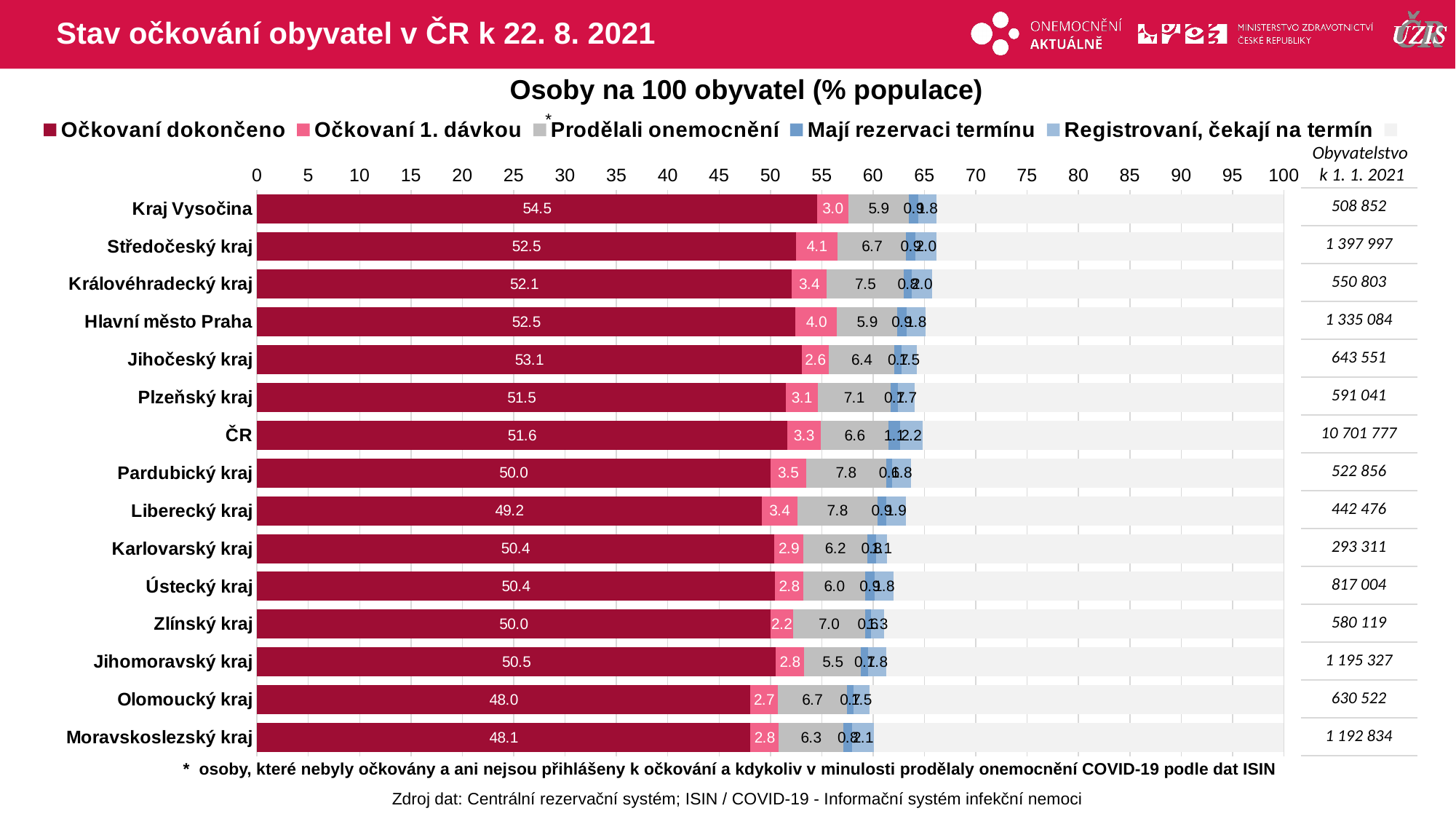
What type of chart is shown on the slide? Stacked bar chart How many regions (categories) are plotted in the chart? 15 What is the 'Očkovaní 1. dávkou' value for Hlavní město Praha? 4.0 Which region has the lowest 'Očkovaní 1. dávkou' value? Zlínský kraj What is the title of the chart? Osoby na 100 obyvatel (% populace) Is the 'Očkovaní dokončeno' value for Moravskoslezský kraj greater or less than 50? less What is the 'Očkovaní dokončeno' value for Kraj Vysočina? 54.5 Which has a larger 'Prodělali onemocnění' value, Pardubický kraj or Jihomoravský kraj? Pardubický kraj What is the 'Prodělali onemocnění' value for Královéhradecký kraj? 7.5 Which region has the highest 'Očkovaní dokončeno' value? Kraj Vysočina Which region has the lowest 'Očkovaní dokončeno' value? Olomoucký kraj What is the difference between the 'Očkovaní dokončeno' values of Kraj Vysočina and Olomoucký kraj? 6.5